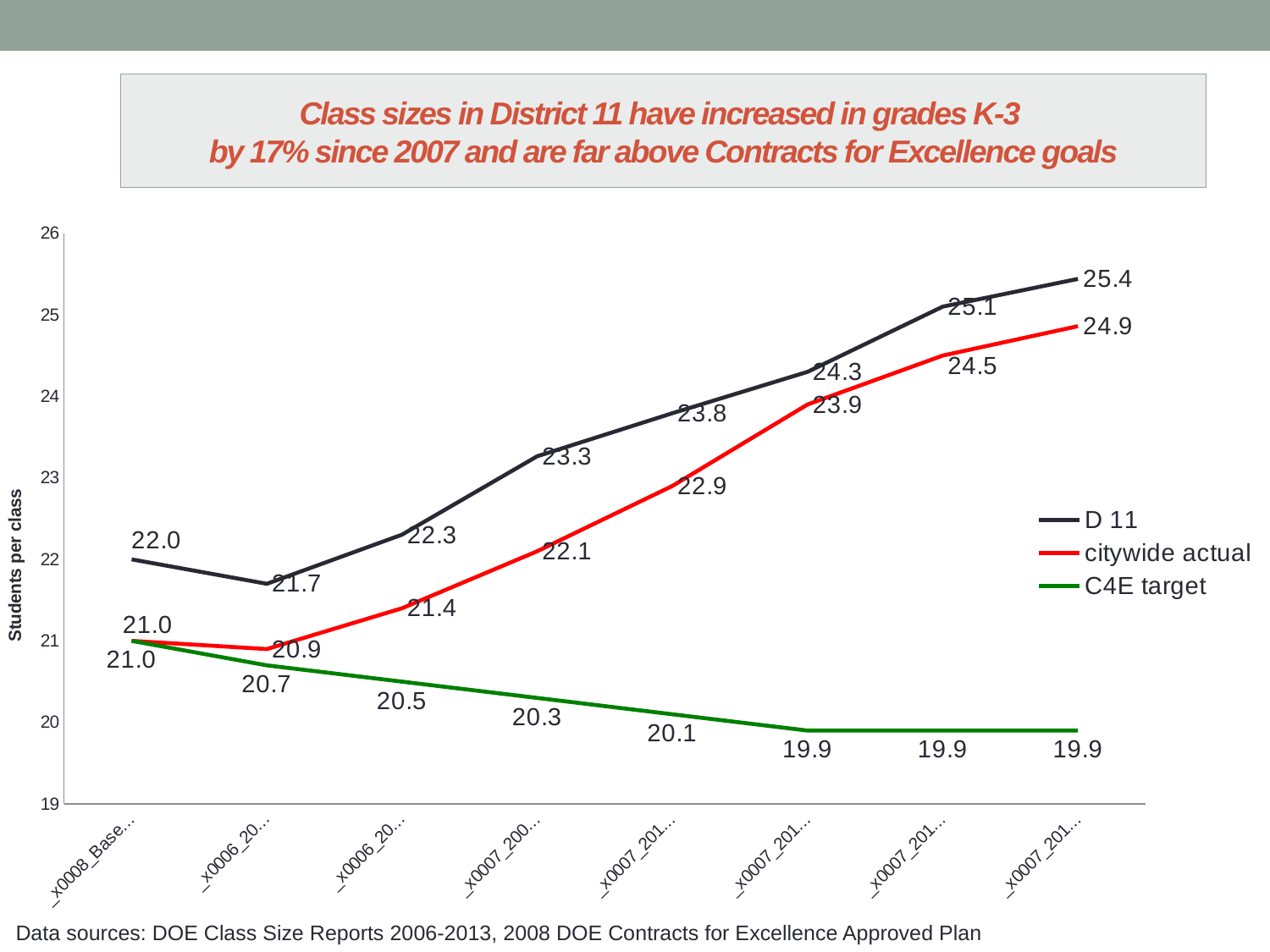
At the last point on the x axis, which series has the larger value, D 11 or citywide actual? D 11 Does the C4E target series rise or fall along the x axis? fall What is the label of the y axis? Students per class How many series does the legend list? 3 What is the highest value plotted for the D 11 series? 25.4 What is the value of the D 11 series at the last point on the x axis? 25.4 How many data points are plotted for the D 11 series? 8 What is the difference between the D 11 value and the C4E target value at the last point on the x axis? 5.5 What is the lowest value plotted for the C4E target series? 19.9 What is the value of the citywide actual series at the last point on the x axis? 24.9 What is the value of the C4E target series at the first point on the x axis? 21.0 What kind of chart is shown on the slide? line chart